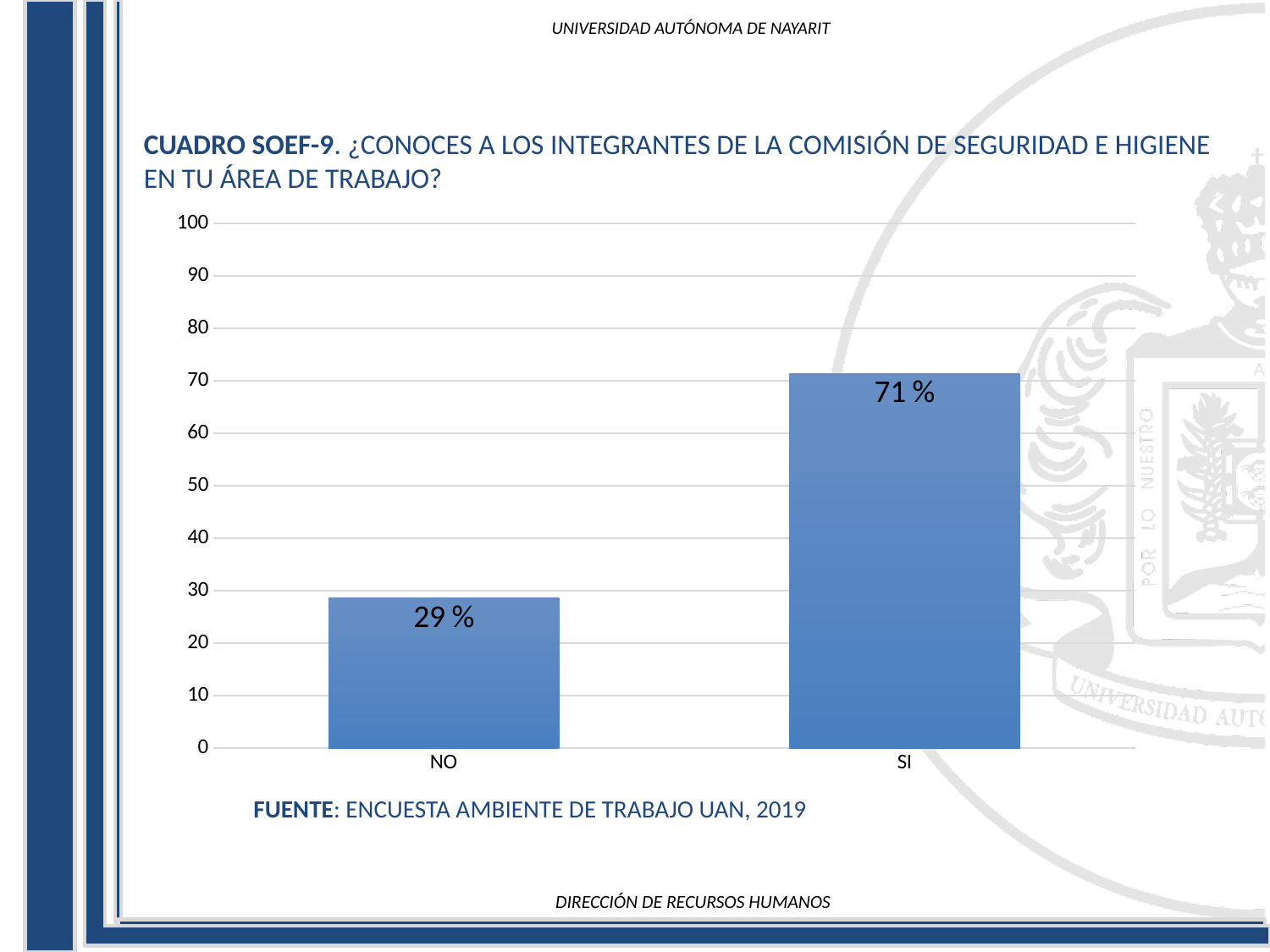
What is the source cited below the chart? ENCUESTA AMBIENTE DE TRABAJO UAN, 2019 What is the value for SI? 71 % What is the highest value shown on the y axis? 100 What is the difference between the values for SI and NO? 42 % Is the value for SI greater or less than 60? greater Is the value for NO greater or less than 40? less Which is larger, the value for NO or the value for SI? SI What kind of chart is shown on the slide? bar chart Which category has the highest value? SI How many categories are shown on the x axis? 2 Which category has the lowest value? NO What is the value for NO? 29 %